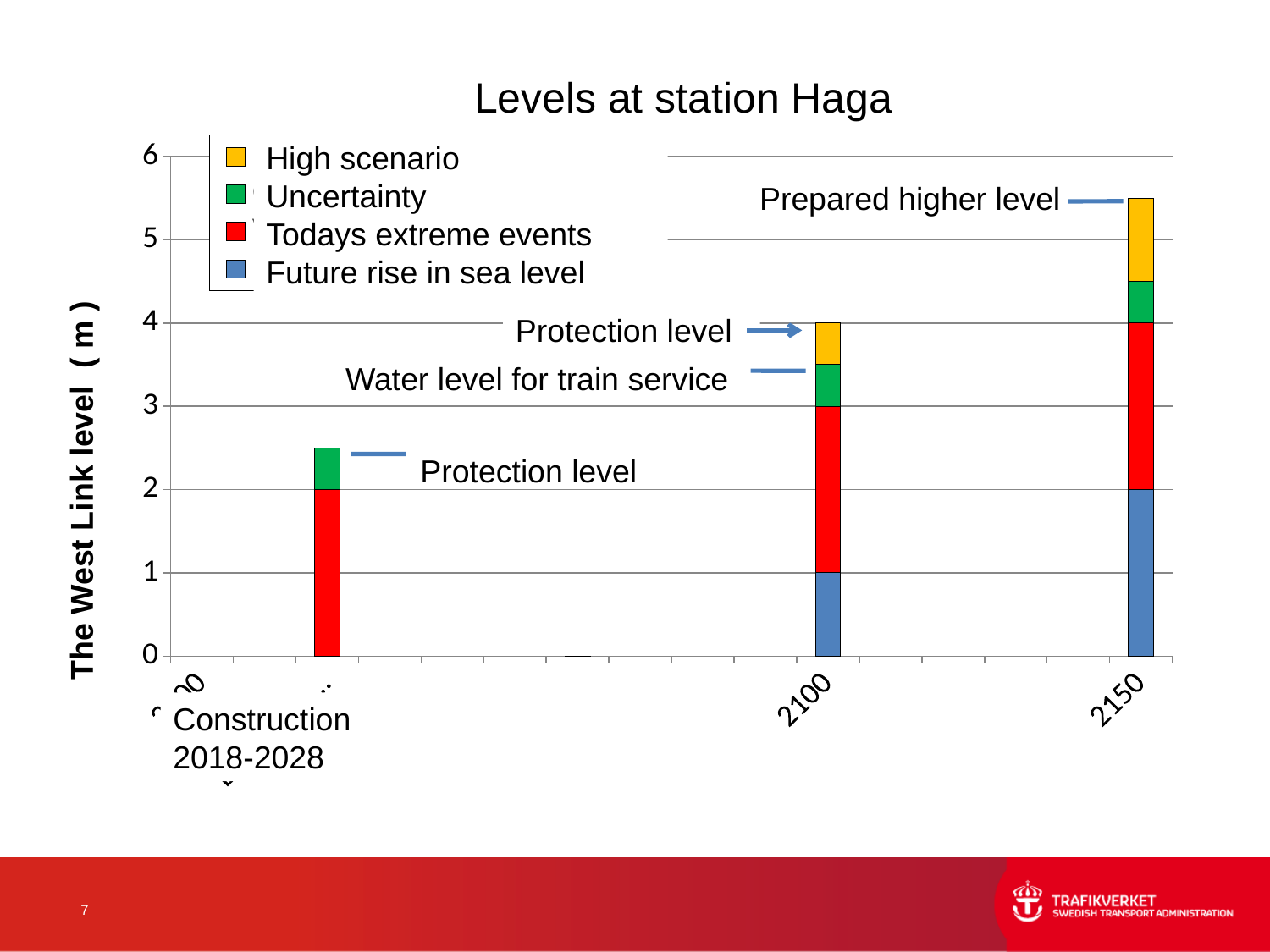
Is the total level of the 2150 bar greater or less than 5? greater What is the title of the y axis? The West Link level (m) Which bar is taller, 2100 or 2150? 2150 What total level (in m) does the top of the 2100 bar reach? 4 Which bar reaches the highest total level? 2150 Which bar reaches the lowest total level? Construction 2018-2028 How many series does the legend list? 4 Do the bar totals rise or fall from left to right along the x axis? rise Is the total level of the Construction 2018-2028 bar greater or less than 3? less What kind of chart is shown on the slide? bar chart Is the Future rise in sea level segment of the 2150 bar greater or less than 1? greater How many bars are plotted in the chart? 3